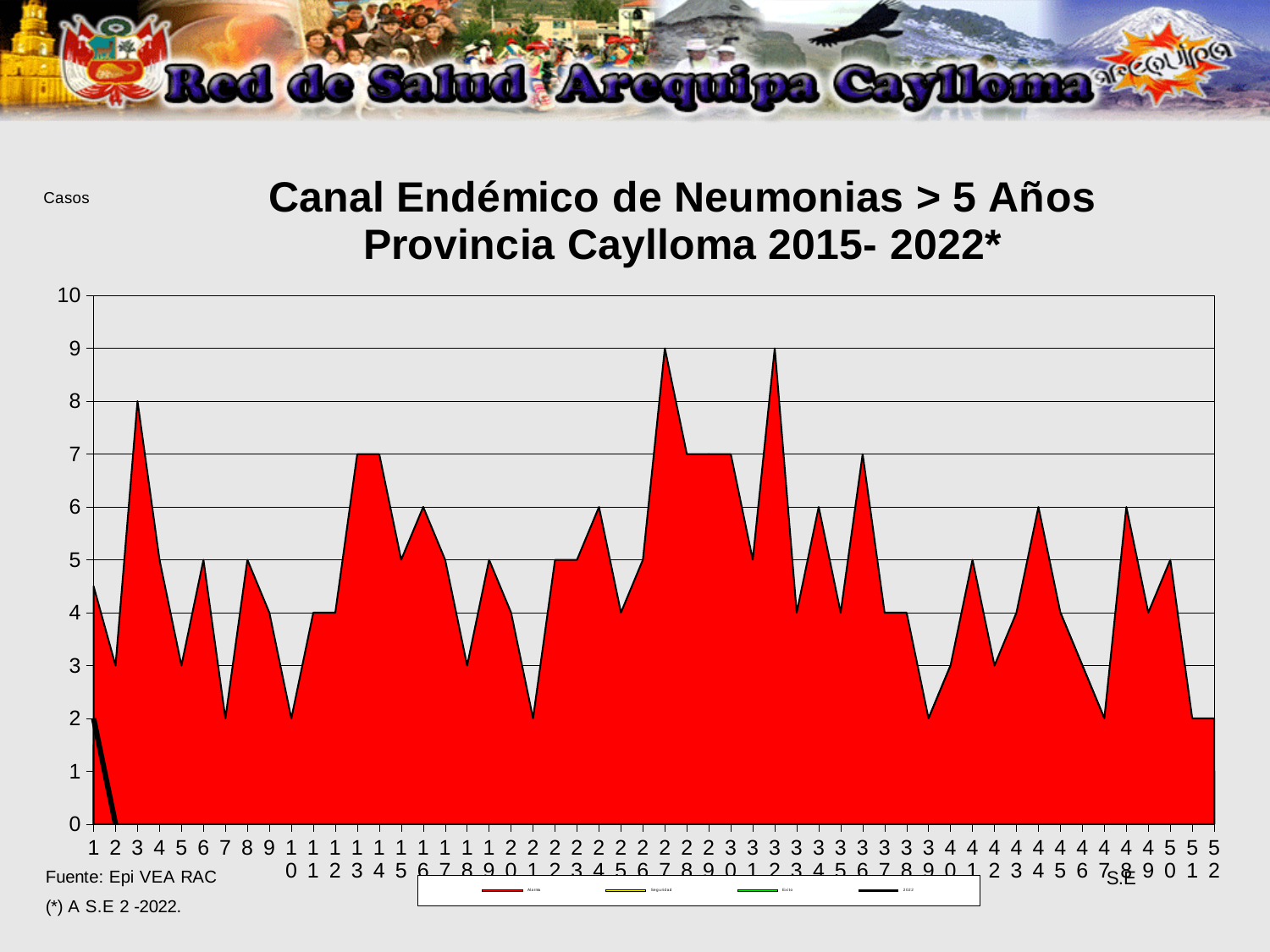
How many weeks are shown on the x axis? 52 What is the value of the black 2022 line at week 2? 0 What kind of chart is shown on the slide? area chart What is the value of the red area at week 3? 8 What is the value of the black 2022 line at week 1? 2 Is the value of the red area at week 3 greater or less than 5? greater What is the highest value reached by the red area on the chart? 9 What is the title of the chart? Canal Endémico de Neumonias > 5 Años Provincia Caylloma 2015- 2022* What is the value of the red area at week 52? 2 Does the black 2022 line rise or fall from week 1 to week 2? fall Which is larger, the red area value at week 3 or at week 2? week 3 Is the value of the red area at week 52 greater or less than 5? less